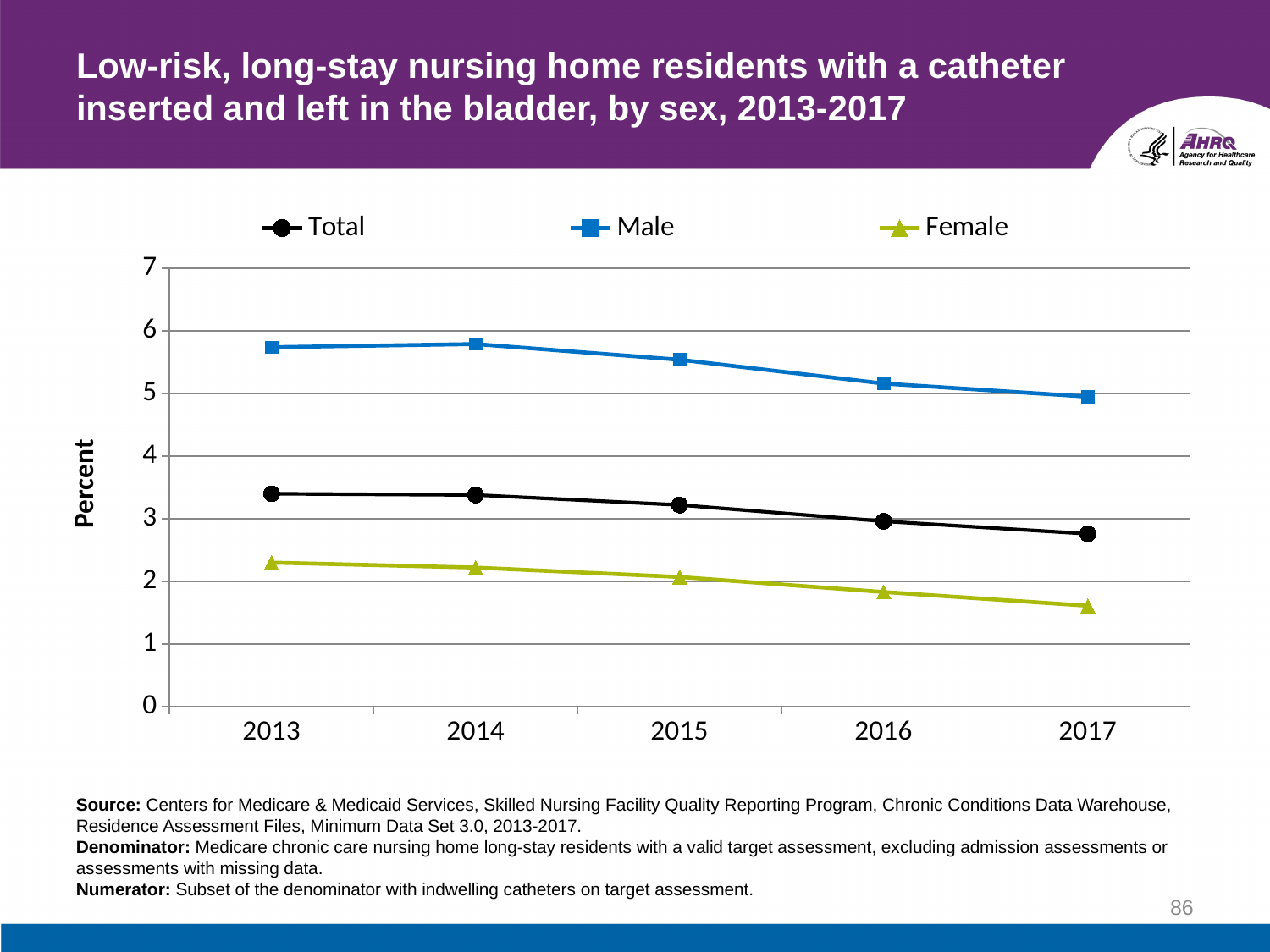
Is the value for Female in 2017 greater or less than 2? less Which series has the highest value in 2015? Male What is the label on the y axis? Percent Is the value for Male in 2013 greater or less than 5? greater What kind of chart is shown on the slide? line chart Which is larger in 2017, the value for Male or the value for Total? Male Is the value for Total in 2013 greater or less than 3? greater How many years are plotted along the x axis? 5 Which series has the lowest value in 2013? Female How many series does the legend list? 3 Does the Female series rise or fall from 2013 to 2017? fall